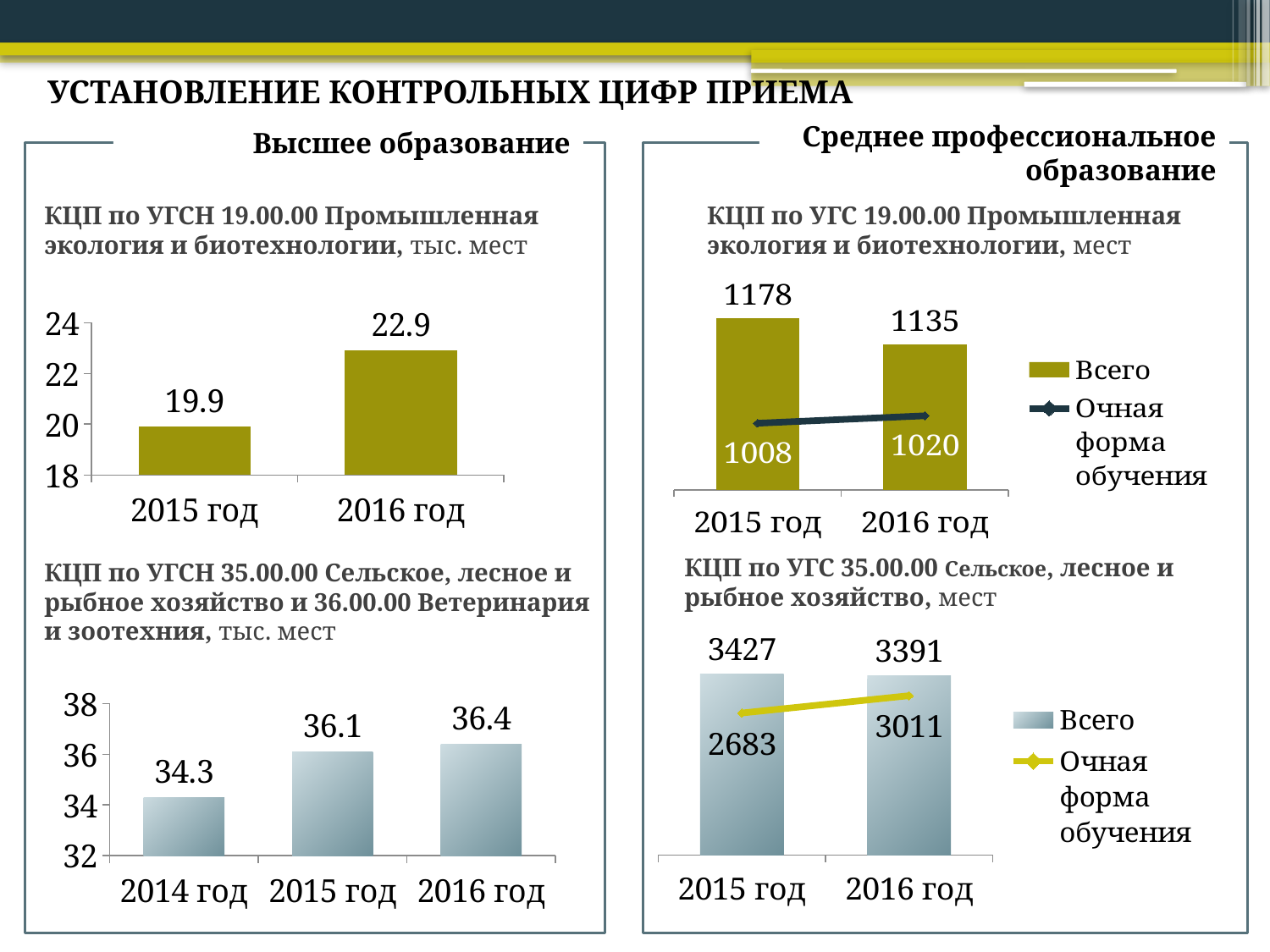
In the bottom-left chart (КЦП по УГСН 35.00.00 и 36.00.00), how many years are plotted? 3 In the top-right chart (КЦП по УГС 19.00.00, мест), what is the Всего value for 2015 год? 1178 In the bottom-left chart (КЦП по УГСН 35.00.00 и 36.00.00), what is the value for 2015 год? 36.1 In the bottom-right chart (КЦП по УГС 35.00.00, мест), what is the Очная форма обучения value for 2015 год? 2683 In the bottom-left chart (КЦП по УГСН 35.00.00 и 36.00.00), which year has the lowest value? 2014 год In the top-right chart (КЦП по УГС 19.00.00, мест), what is the Очная форма обучения value for 2016 год? 1020 In the bottom-left chart (КЦП по УГСН 35.00.00 и 36.00.00), do the values rise or fall from 2014 год to 2016 год? rise In the top-right chart (КЦП по УГС 19.00.00, мест), how many series does the legend list? 2 In the bottom-right chart (КЦП по УГС 35.00.00, мест), what is the difference between the Всего values for 2015 год and 2016 год? 36 In the top-left chart (КЦП по УГСН 19.00.00), what is the difference between the 2016 год and 2015 год values? 3.0 In the top-left chart (КЦП по УГСН 19.00.00 Промышленная экология и биотехнологии), what is the value for 2016 год? 22.9 What kind of chart is the top-left chart (КЦП по УГСН 19.00.00)? bar chart